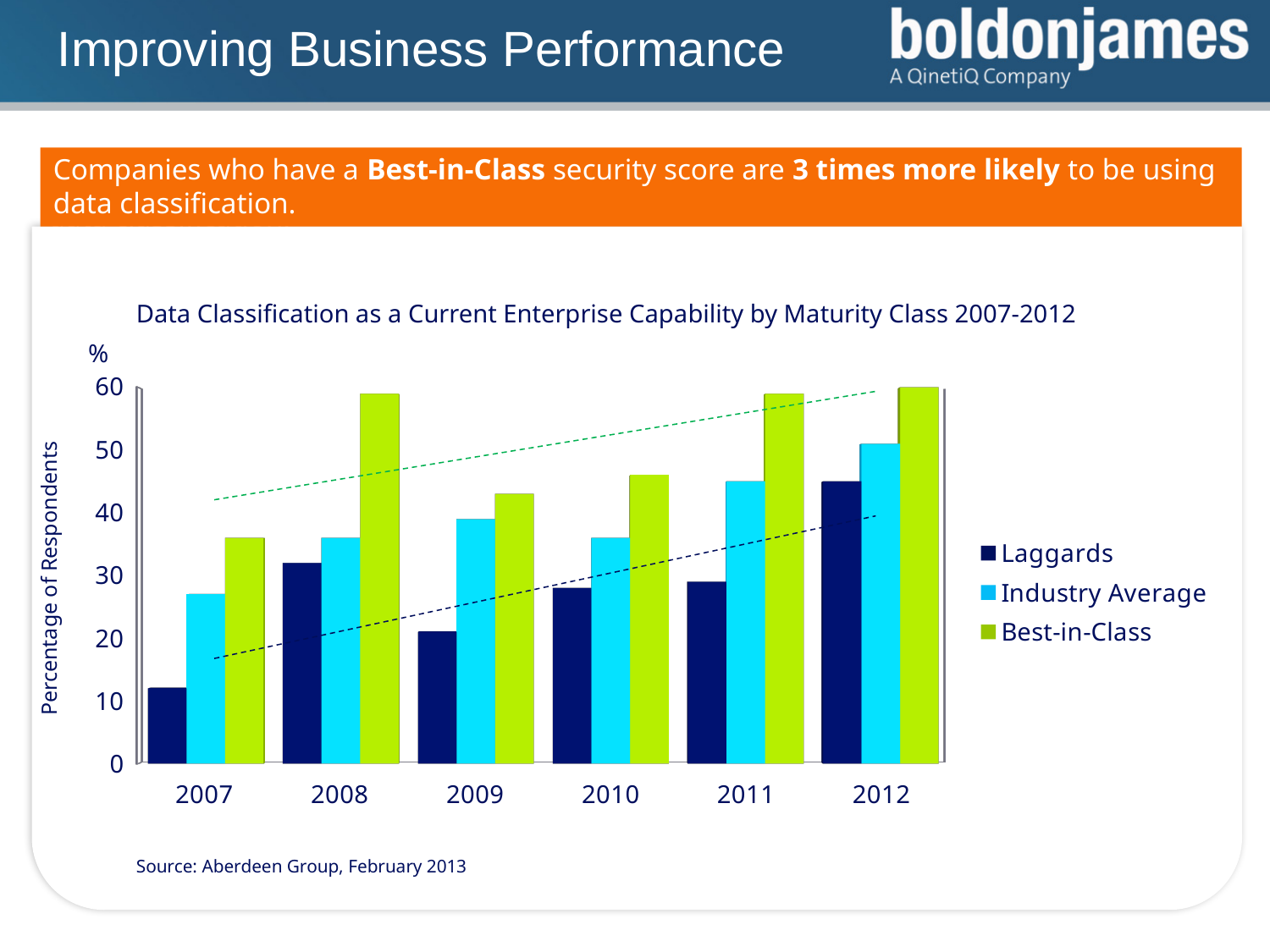
Do the Best-in-Class values rise or fall from 2009 to 2012? rise Is the value for Industry Average in 2011 greater or less than 40? greater Which is larger, the Laggards value in 2008 or in 2009? 2008 How many series does the legend list? 3 Is the value for Laggards in 2007 greater or less than 20? less In which year is the Industry Average value lowest? 2007 Is the value for Best-in-Class in 2008 greater or less than 50? greater In which year is the Laggards value highest? 2012 What is the label on the y axis of the chart? Percentage of Respondents How many years are shown on the x axis? 6 What kind of chart is shown on the slide? Bar chart